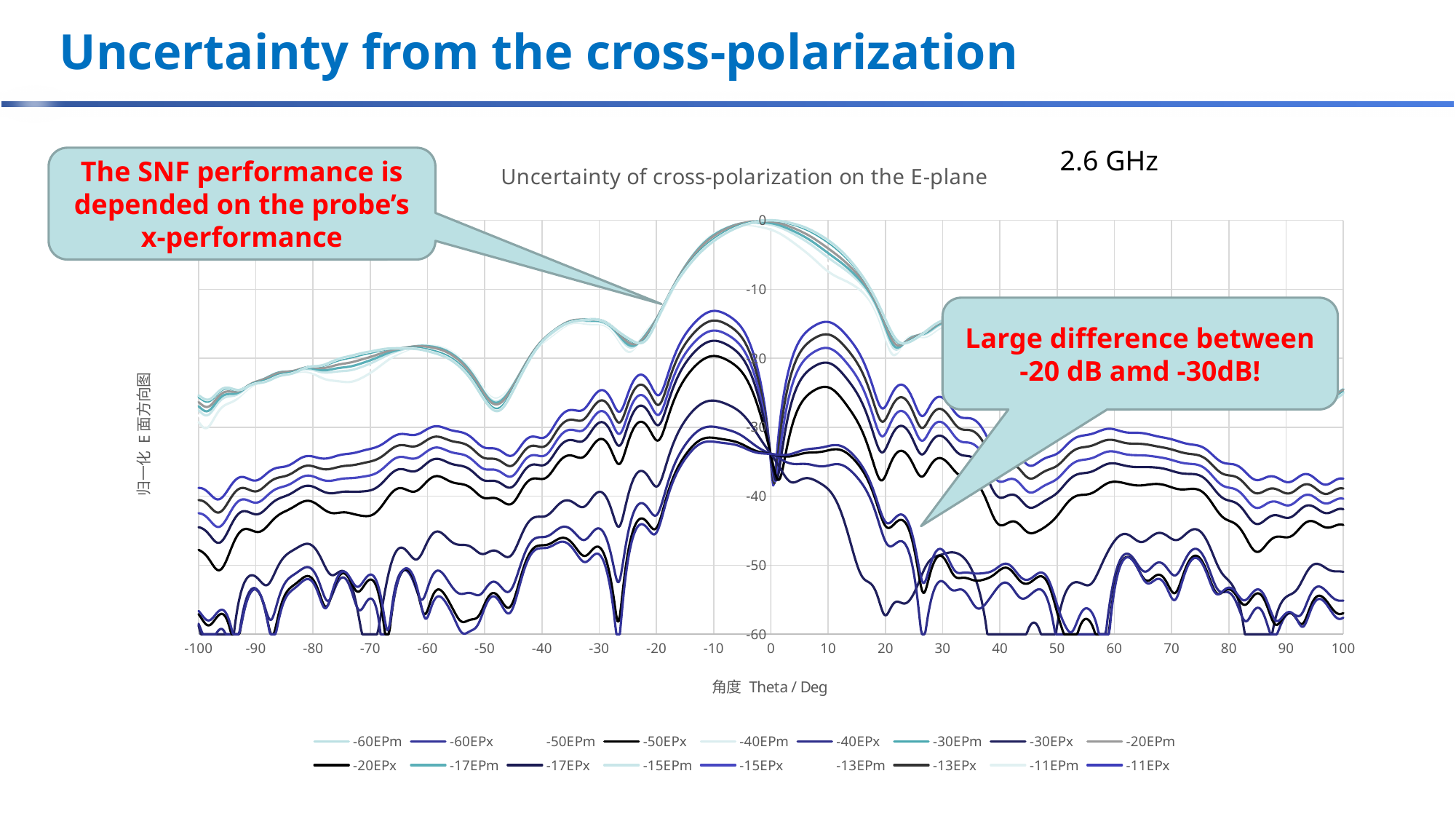
What is the lowest value shown on the y axis of the chart? -60 What is the rightmost tick value on the x axis of the chart? 100 What is the title of the chart? Uncertainty of cross-polarization on the E-plane Near Theta = -10, is the value of the topmost curves greater or less than -10? greater How many series does the legend of the chart list? 18 What kind of chart is shown on the slide? line chart What is the label of the x axis of the chart? 角度 Theta / Deg What is the leftmost tick value on the x axis of the chart? -100 How many tick labels are shown on the x axis of the chart? 21 What is the highest value shown on the y axis of the chart? 0 What frequency is stated next to the chart? 2.6 GHz At Theta = -100, is the value of the lowest curves greater or less than -50? less